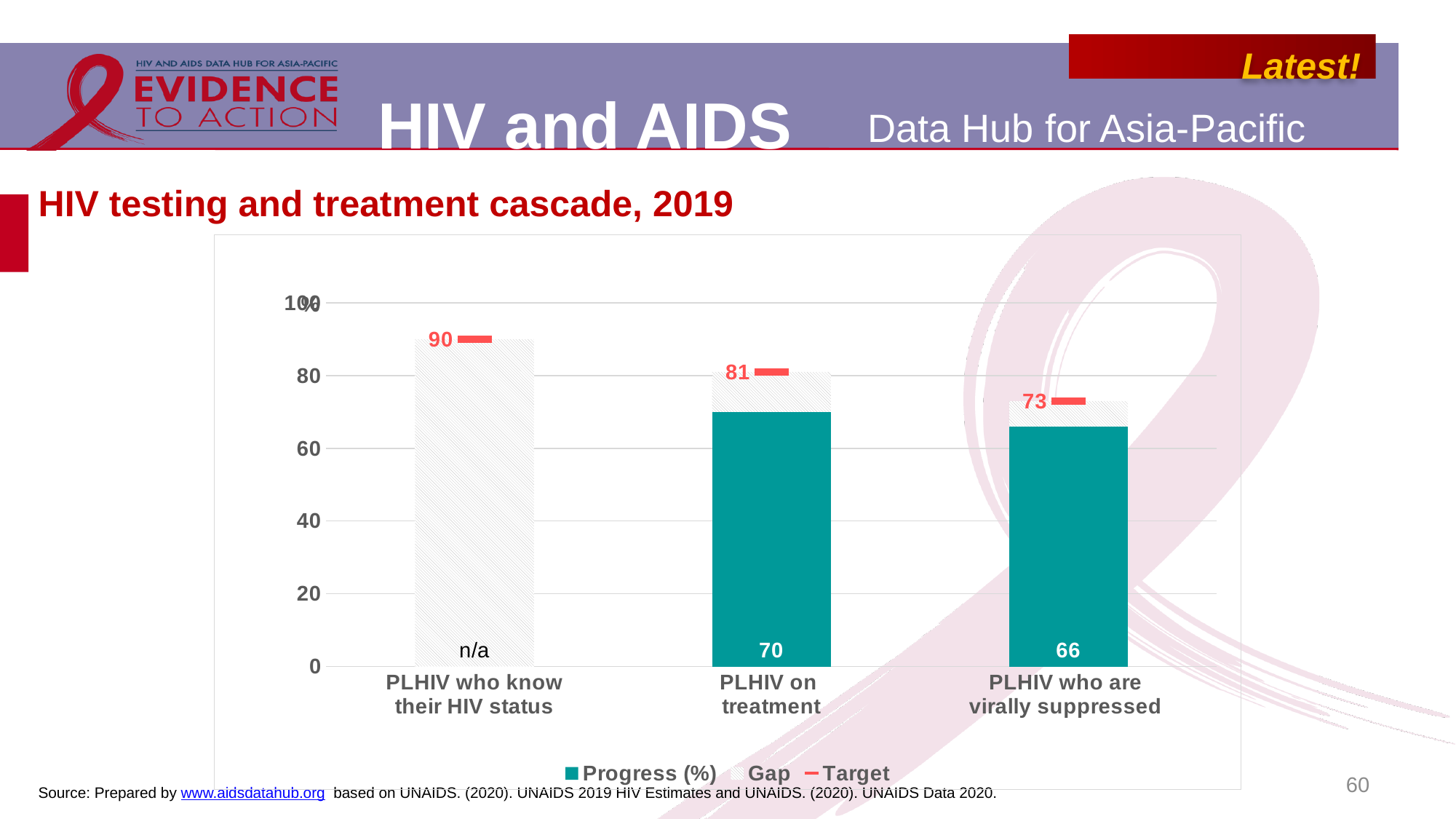
What is the Target value for PLHIV on treatment? 81 What is the Progress (%) value shown for PLHIV who know their HIV status? n/a What is the Progress (%) value for PLHIV who are virally suppressed? 66 How many categories are shown on the x axis of the chart? 3 What is the Target value for PLHIV who are virally suppressed? 73 What is the Progress (%) value for PLHIV on treatment? 70 Which category has the highest Target value? PLHIV who know their HIV status What is the Target value for PLHIV who know their HIV status? 90 What is the difference between the Target and the Progress (%) for PLHIV on treatment? 11 Which is larger, the Progress (%) for PLHIV on treatment or for PLHIV who are virally suppressed? PLHIV on treatment How many series does the chart legend list? 3 What is the difference between the Target and the Progress (%) for PLHIV who are virally suppressed? 7